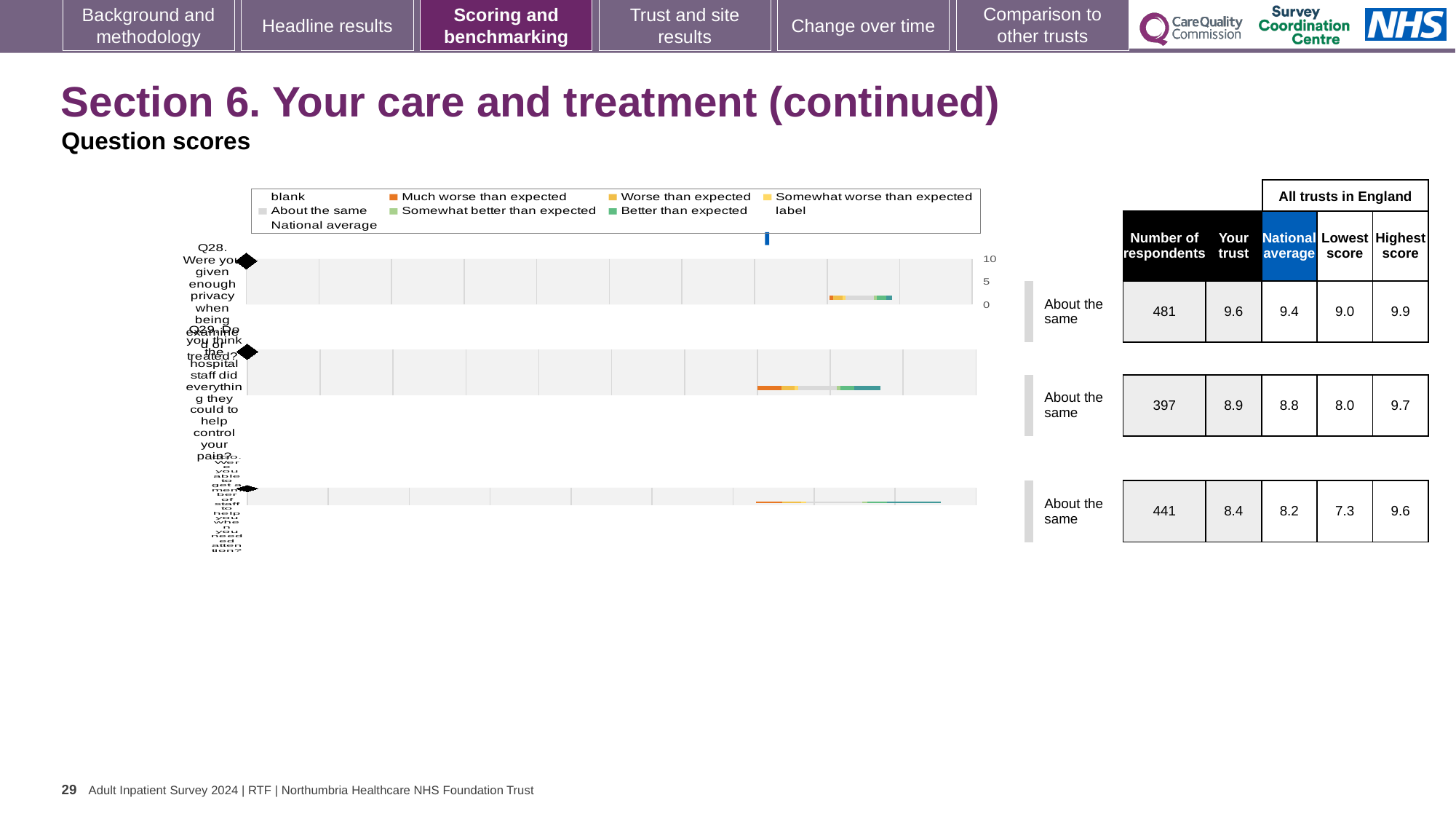
What benchmark category is shown for all three questions on this slide? About the same For Q29 (hospital staff helping control your pain), how many respondents are there? 397 For Q28, what is the difference between the 'Your trust' score and the national average? 0.2 For Q29, what is the highest score among all trusts in England? 9.7 For Q29, which is larger: the 'Your trust' score or the national average? Your trust For the third chart (Q30), what is the national average score? 8.2 Which question has the lowest 'Lowest score' across all trusts in England? Q30 Which legend entry is shown in orange? Much worse than expected What type of chart is used to show the question scores on this slide? bar chart Which question has the highest 'Your trust' score? Q28 For Q28 (privacy when being examined or treated), what is the 'Your trust' score? 9.6 How many questions (charts) are plotted on this slide? 3